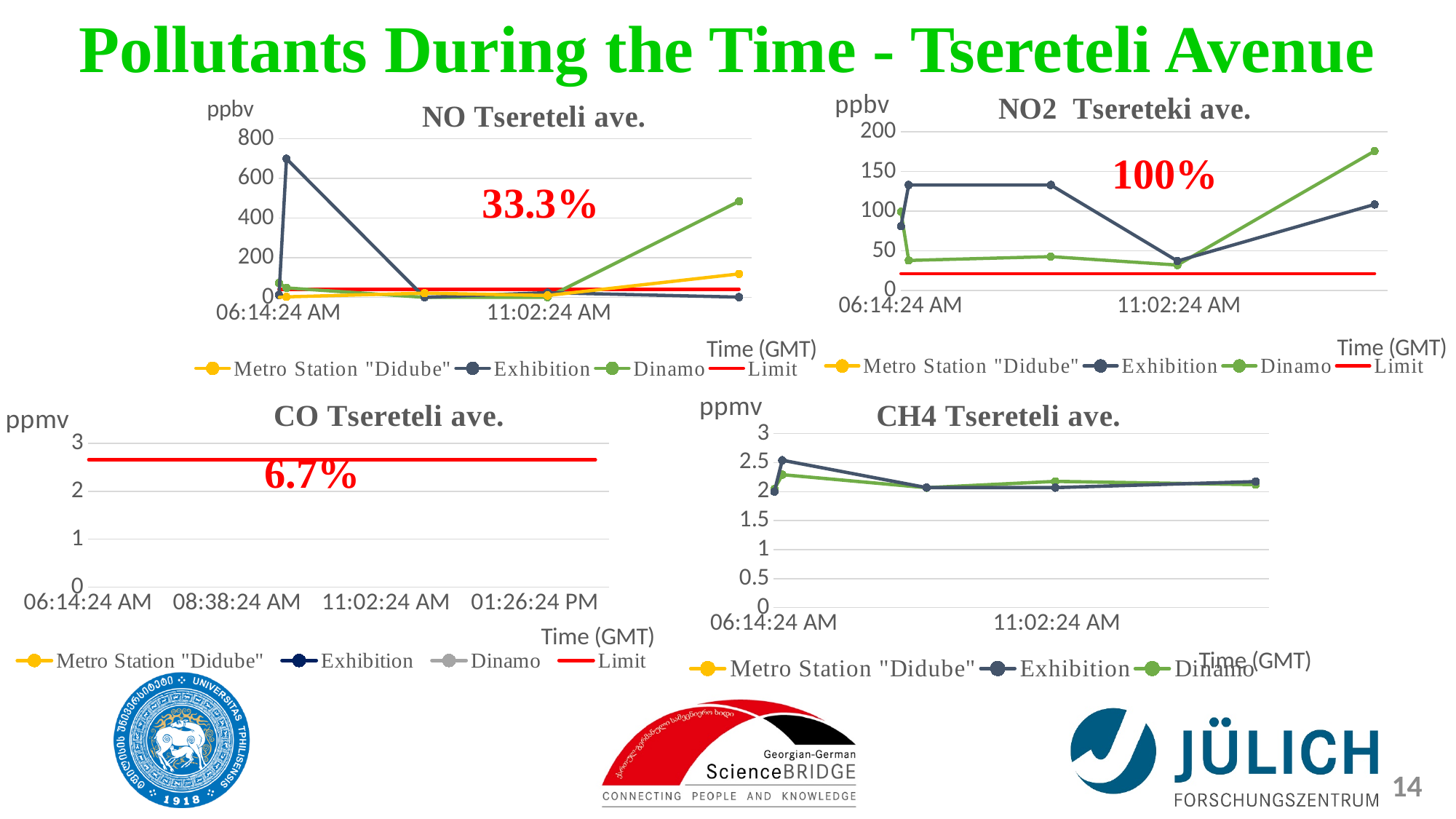
How many series does the legend of the "NO2 Tsereteki ave." chart list? 4 In the "NO2 Tsereteki ave." chart, which series has the larger value at 06:14:24 AM, Exhibition or Dinamo? Dinamo In the "NO Tsereteli ave." chart, is the highest value of the Exhibition series greater or less than 600? greater What kind of chart is the "NO Tsereteli ave." chart? line chart In the "NO2 Tsereteki ave." chart, is the Limit line greater or less than 50? less In the "CO Tsereteli ave." chart, is the Limit line greater or less than 2? greater How many series does the legend of the "CH4 Tsereteli ave." chart list? 3 What percentage is printed in red on the "CO Tsereteli ave." chart? 6.7% In the "NO2 Tsereteki ave." chart, which series ends higher at the last time point, Exhibition or Dinamo? Dinamo